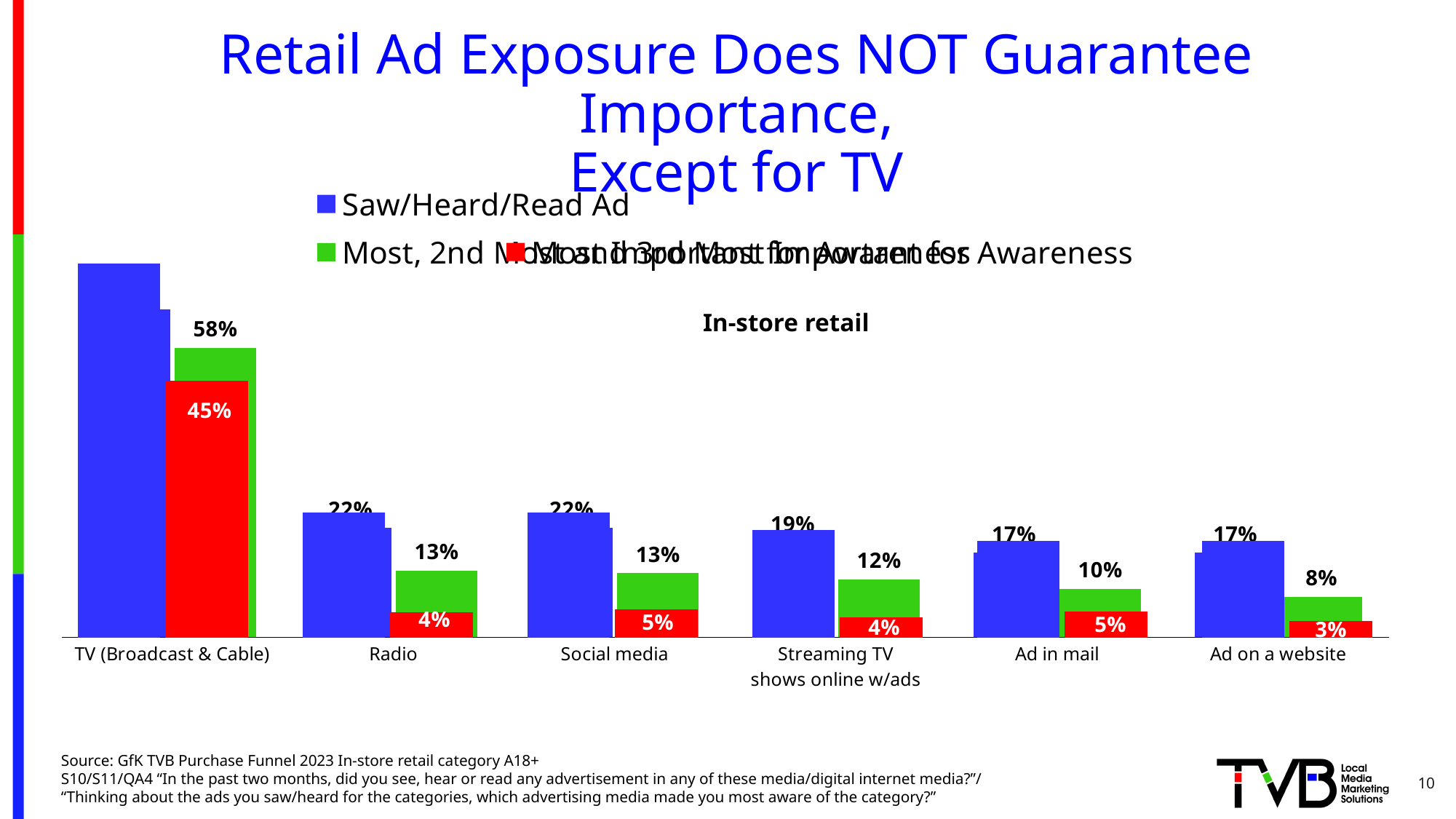
Which category has the highest value for the green series? TV (Broadcast & Cable) What is the value of the green bar for TV (Broadcast & Cable)? 58% What is the Saw/Heard/Read Ad value for Streaming TV shows online w/ads? 19% How many media categories are shown on the x axis? 6 What is the Saw/Heard/Read Ad value for Radio? 22% What is the difference between the green bar and the red bar for TV (Broadcast & Cable)? 13% Is the green bar larger for Radio or for Streaming TV shows online w/ads? Radio Which category has the lowest value for the red series? Ad on a website What is the value of the green bar for Ad on a website? 8% How many series does the legend list? 3 What is the value of the red bar for TV (Broadcast & Cable)? 45% What is the value of the red bar for Social media? 5%